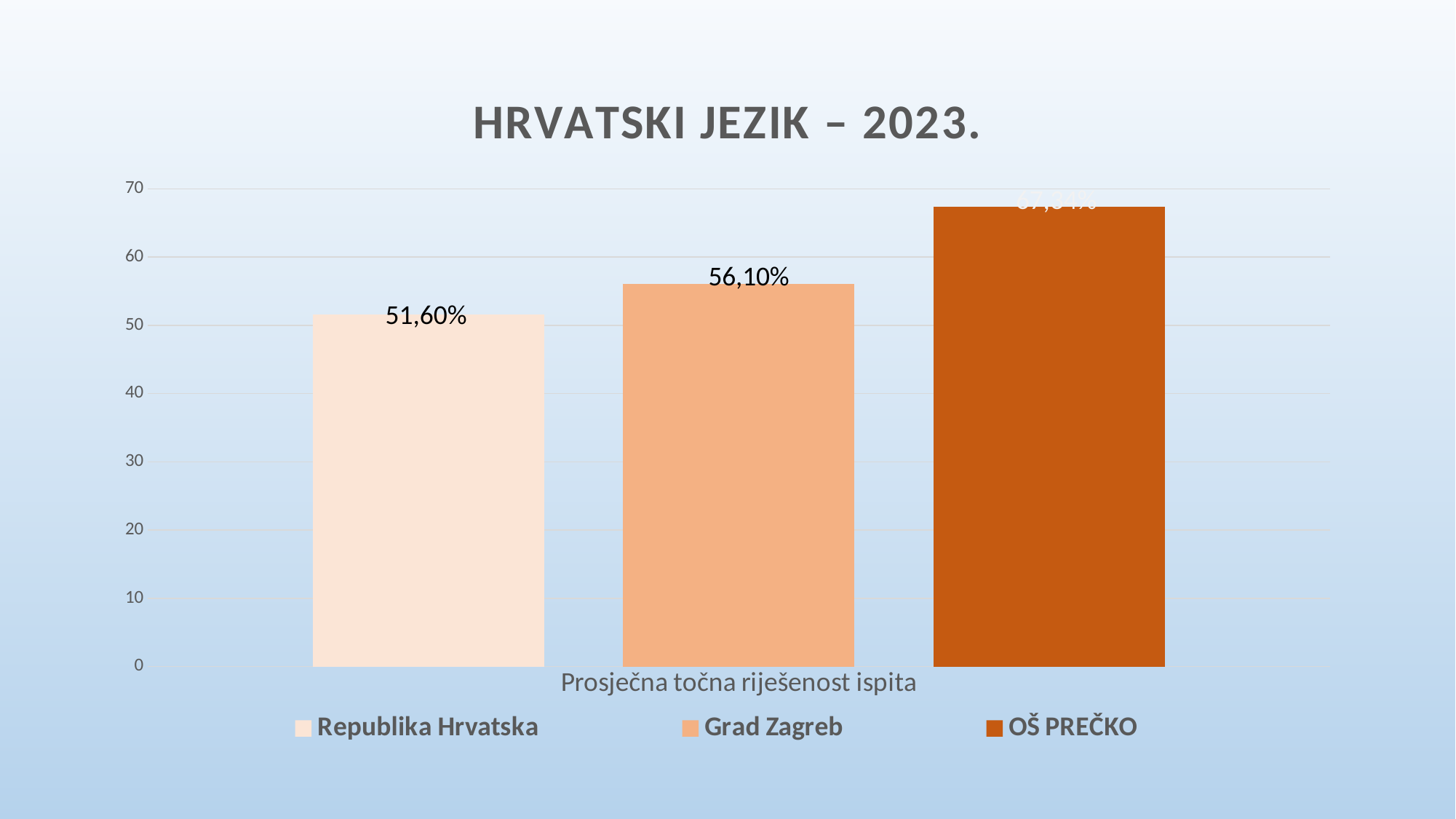
Which is larger, the value for Grad Zagreb or the value for Republika Hrvatska? Grad Zagreb Which series has the lowest value? Republika Hrvatska What is the value for Republika Hrvatska? 51,60% Which series has the highest value? OŠ PREČKO What is the title of the chart? HRVATSKI JEZIK – 2023. How many series does the legend list? 3 Is the value for OŠ PREČKO greater or less than 60? greater What kind of chart is shown on the slide? bar chart What is the difference between the values for Grad Zagreb and Republika Hrvatska? 4,50% Is the value for Republika Hrvatska greater or less than 60? less How many bars are plotted on the chart? 3 What is the value for Grad Zagreb? 56,10%